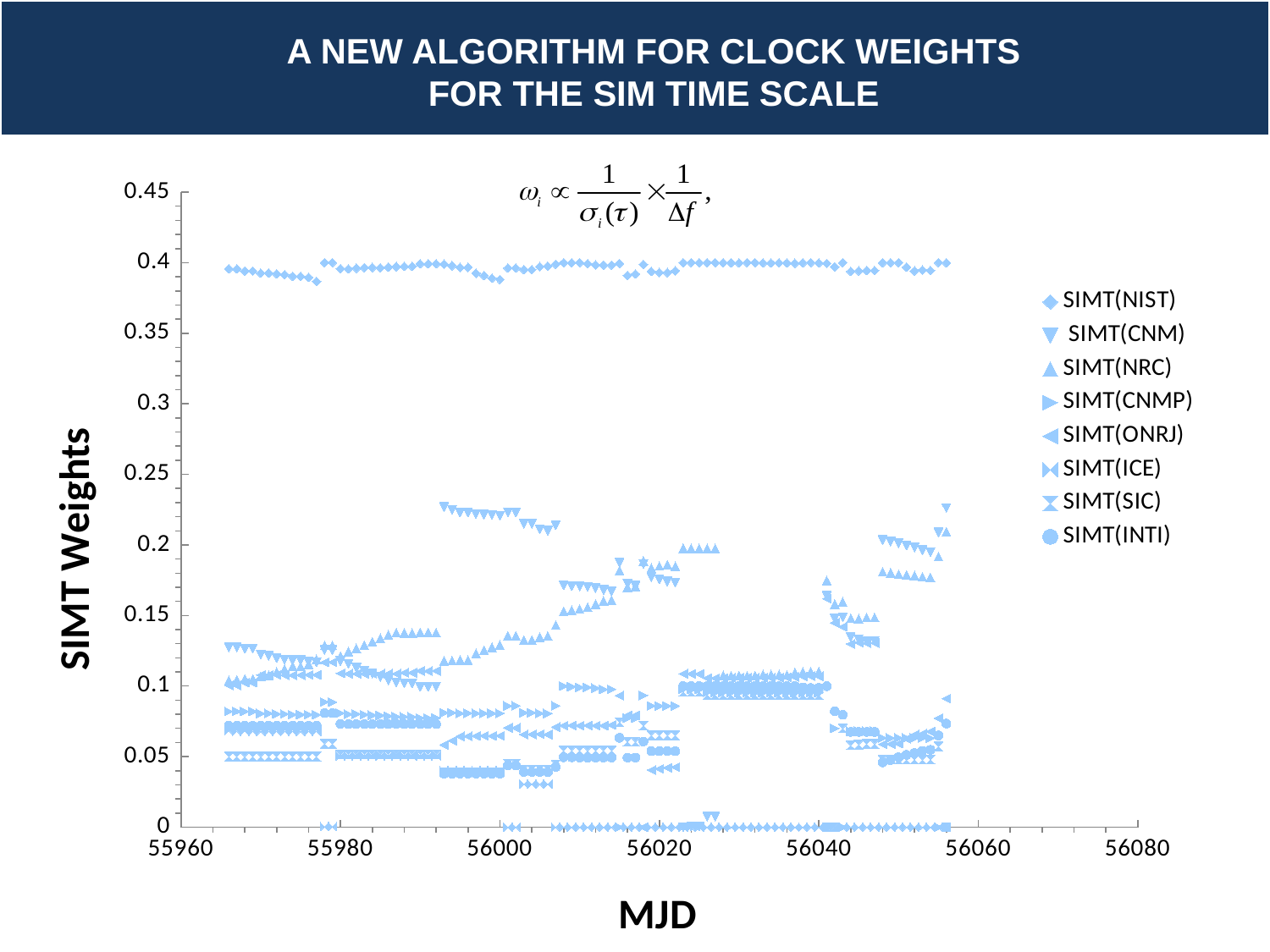
Is the value for SIMT(NIST) at MJD 56000 greater or less than 0.35? greater What is the label of the horizontal axis? MJD At MJD 56000, which series has the larger value, SIMT(NIST) or SIMT(CNM)? SIMT(NIST) What is the label of the vertical axis? SIMT Weights What kind of chart is shown on the slide? scatter chart How many series does the legend list? 8 Is the value for SIMT(NIST) at MJD 56040 greater or less than 0.45? less Is the value for SIMT(NRC) at MJD 56000 greater or less than 0.2? less Which series has the highest SIMT weights across the whole MJD range? SIMT(NIST)